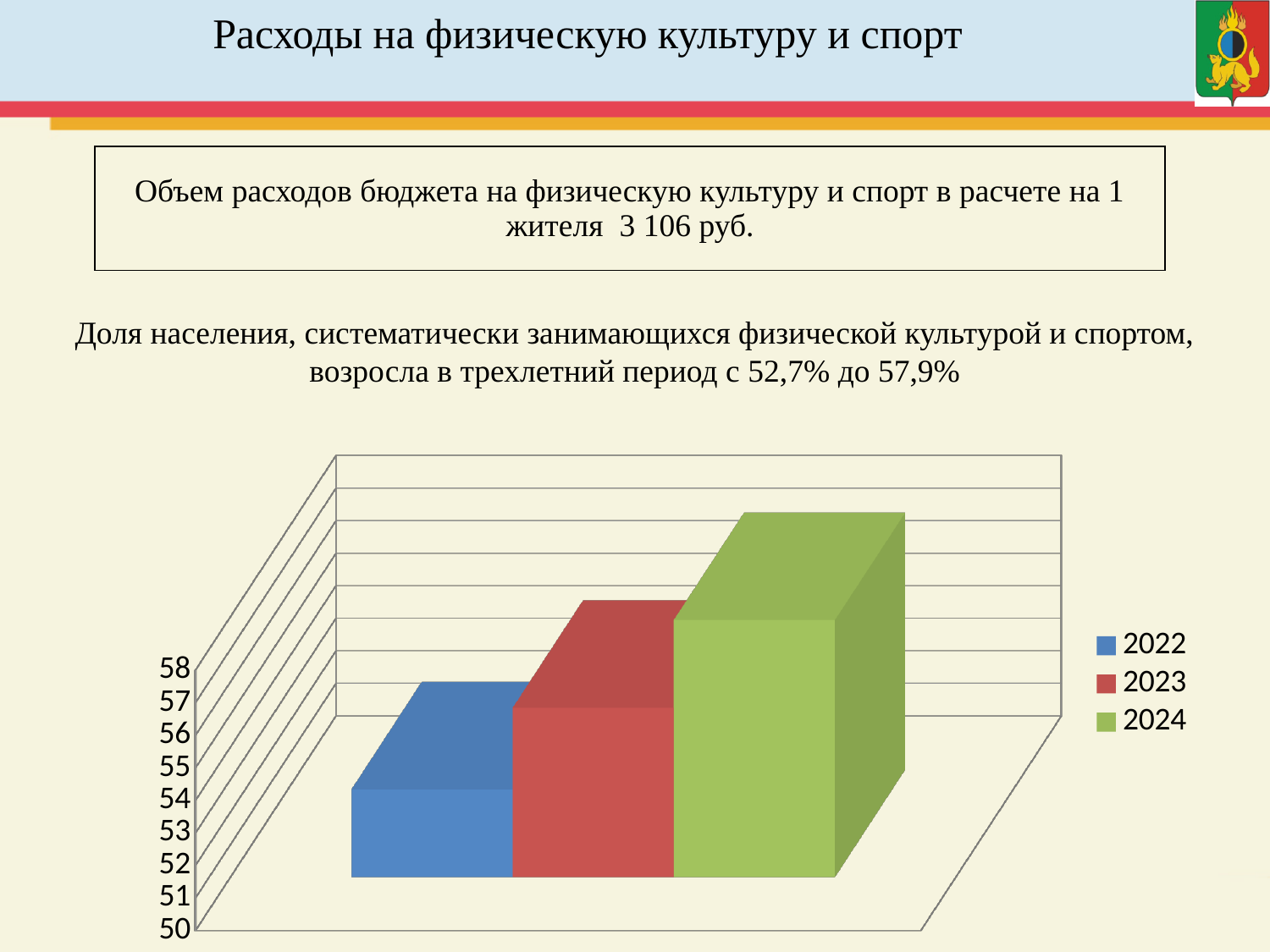
What colour is the bar for 2024? green How many entries does the chart legend list? 3 Which bar is taller, 2022 or 2023? 2023 Do the bar values rise or fall from 2022 to 2024? rise Is the value for 2022 greater or less than 56? less Which bar is taller, 2023 or 2024? 2024 How many bars are plotted in the chart? 3 Which year has the highest bar in the chart? 2024 Is the value for 2024 greater or less than 55? greater What are the legend entries of the chart? 2022, 2023, 2024 What kind of chart is shown on the slide? bar chart Which year has the lowest bar in the chart? 2022